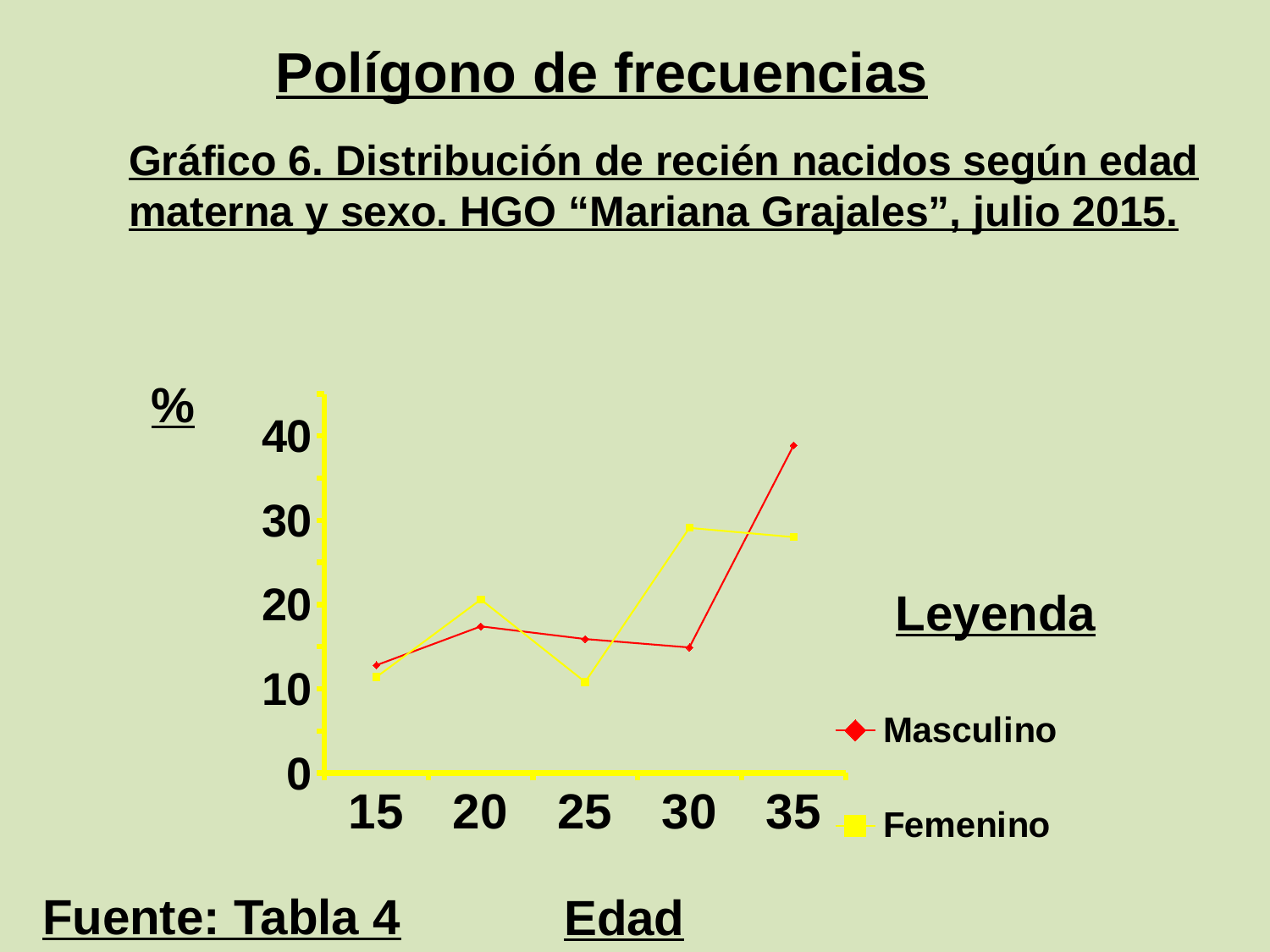
Is the Masculino value at age 35 greater or less than 30? greater At which age is the Masculino series lowest? 15 At age 30, which series has the larger value, Masculino or Femenino? Femenino At which age is the Masculino series highest? 35 Does the Masculino series rise or fall between age 30 and age 35? rise Is the Femenino value at age 25 greater or less than 20? less At age 35, which series has the larger value, Masculino or Femenino? Masculino How many age categories are plotted along the x axis? 5 How many series does the legend list? 2 What kind of chart is shown on the slide? line chart Is the Femenino value at age 30 greater or less than 20? greater What source is cited below the chart? Tabla 4